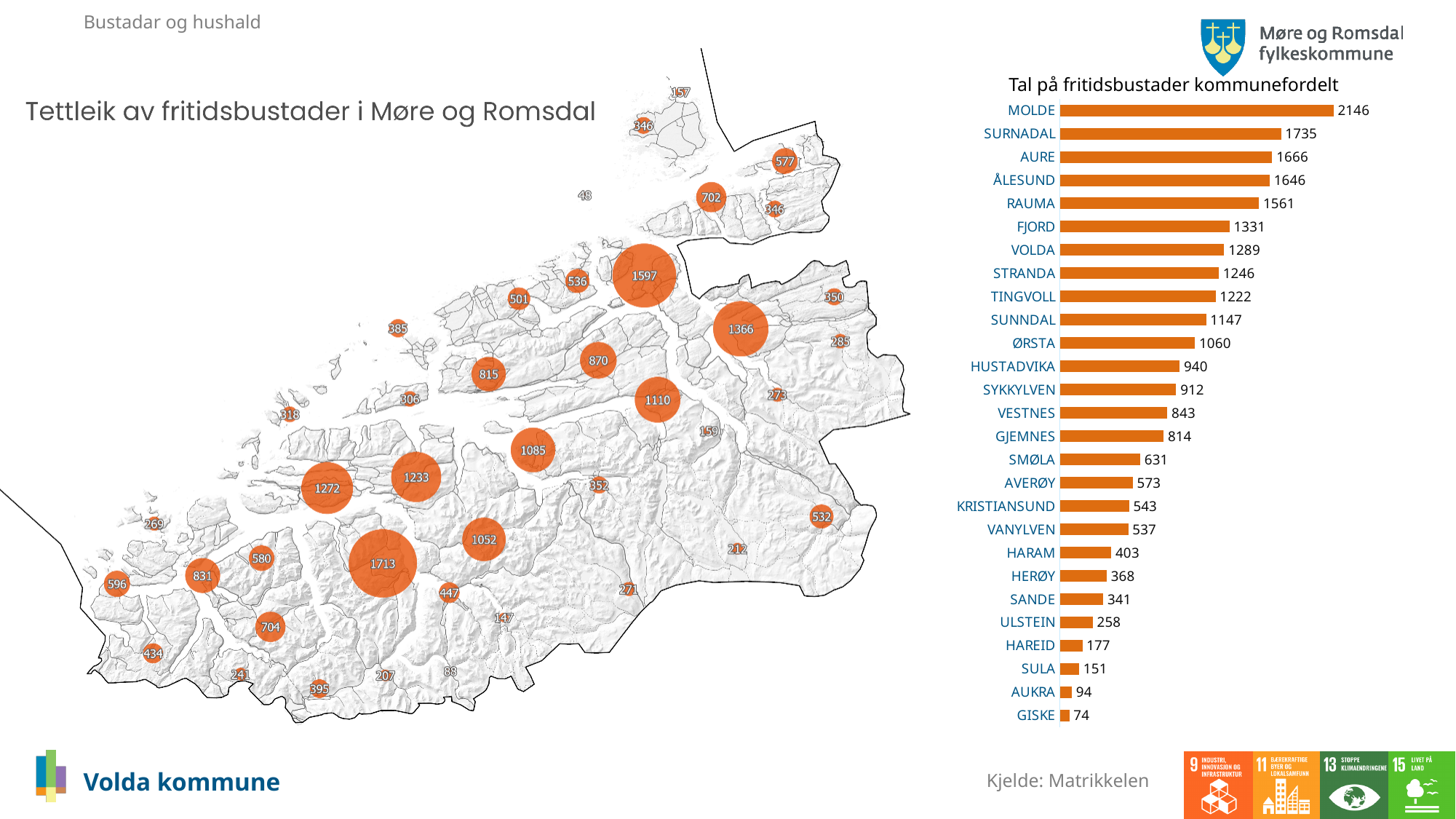
In the bar chart 'Tal på fritidsbustader kommunefordelt', what is the difference between the values for MOLDE and SURNADAL? 411 In the bar chart 'Tal på fritidsbustader kommunefordelt', what is the value for VOLDA? 1289 In the bar chart 'Tal på fritidsbustader kommunefordelt', what is the difference between the values for VOLDA and ØRSTA? 229 In the bar chart 'Tal på fritidsbustader kommunefordelt', which has a larger value, HARAM or SMØLA? SMØLA How many municipalities are listed in the bar chart 'Tal på fritidsbustader kommunefordelt'? 27 In the bar chart 'Tal på fritidsbustader kommunefordelt', what is the value for SURNADAL? 1735 What is the source cited at the bottom of the slide for the data? Matrikkelen In the bar chart 'Tal på fritidsbustader kommunefordelt', which municipality has the highest value? MOLDE In the bar chart 'Tal på fritidsbustader kommunefordelt', what is the value for KRISTIANSUND? 543 What kind of chart is 'Tal på fritidsbustader kommunefordelt'? Bar chart In the bar chart 'Tal på fritidsbustader kommunefordelt', which has a larger value, AURE or RAUMA? AURE In the bar chart 'Tal på fritidsbustader kommunefordelt', which municipality has the lowest value? GISKE